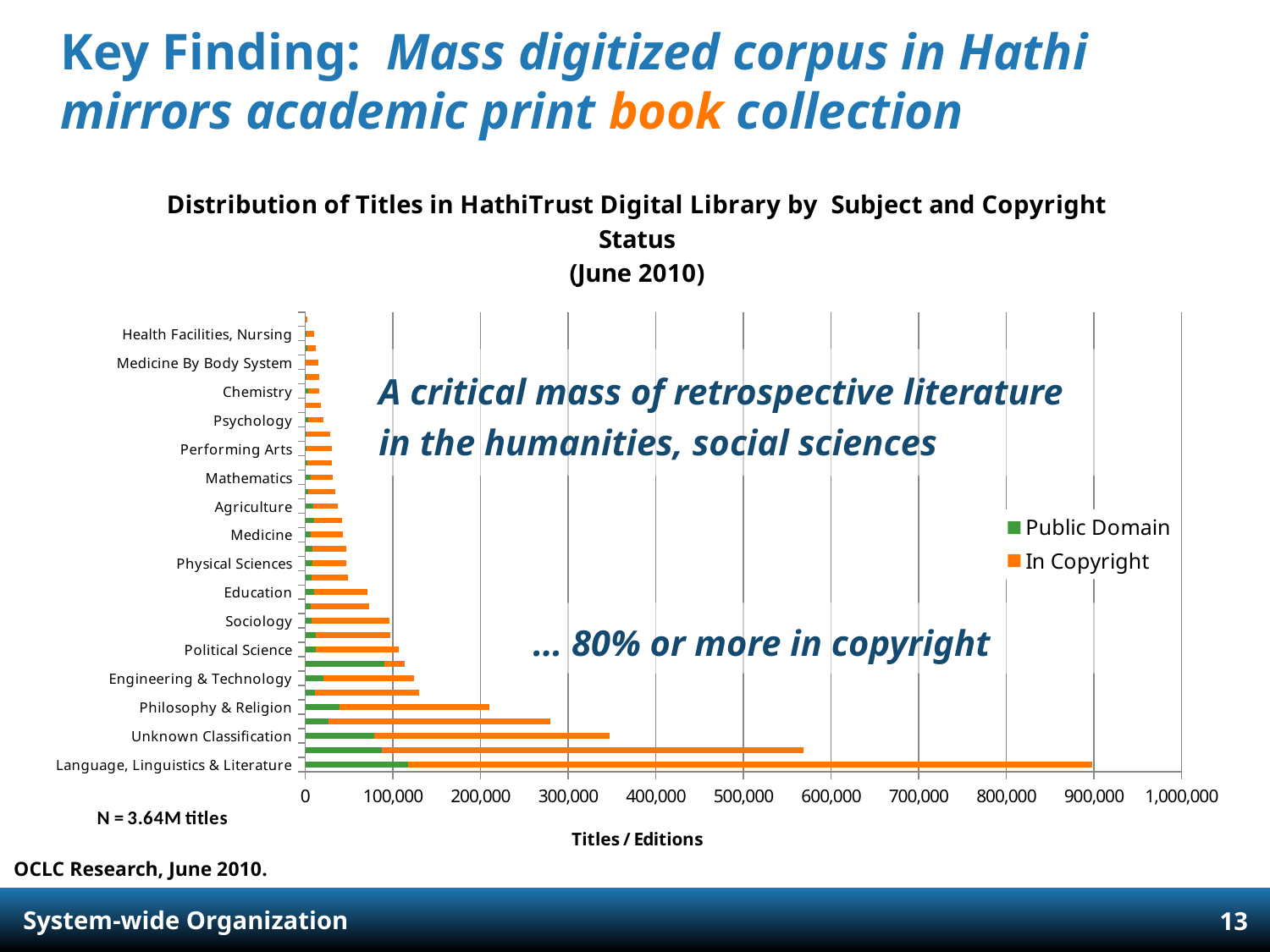
Is the total value for Engineering & Technology greater or less than 100,000? greater What is the title of the horizontal axis of the chart? Titles / Editions Is the total value for Language, Linguistics & Literature greater or less than 800,000? greater Do the bar lengths increase or decrease moving from the top of the chart to the bottom? Increase What kind of chart is shown on the slide? Bar chart Which subject has the highest total number of titles in the chart? Language, Linguistics & Literature Is the total value for Unknown Classification greater or less than 300,000? greater Which colour represents the In Copyright series in the chart? Orange Which has more titles in total, Unknown Classification or Philosophy & Religion? Unknown Classification Which labeled subject has the lowest total number of titles in the chart? Health Facilities, Nursing How many series does the chart legend list? 2